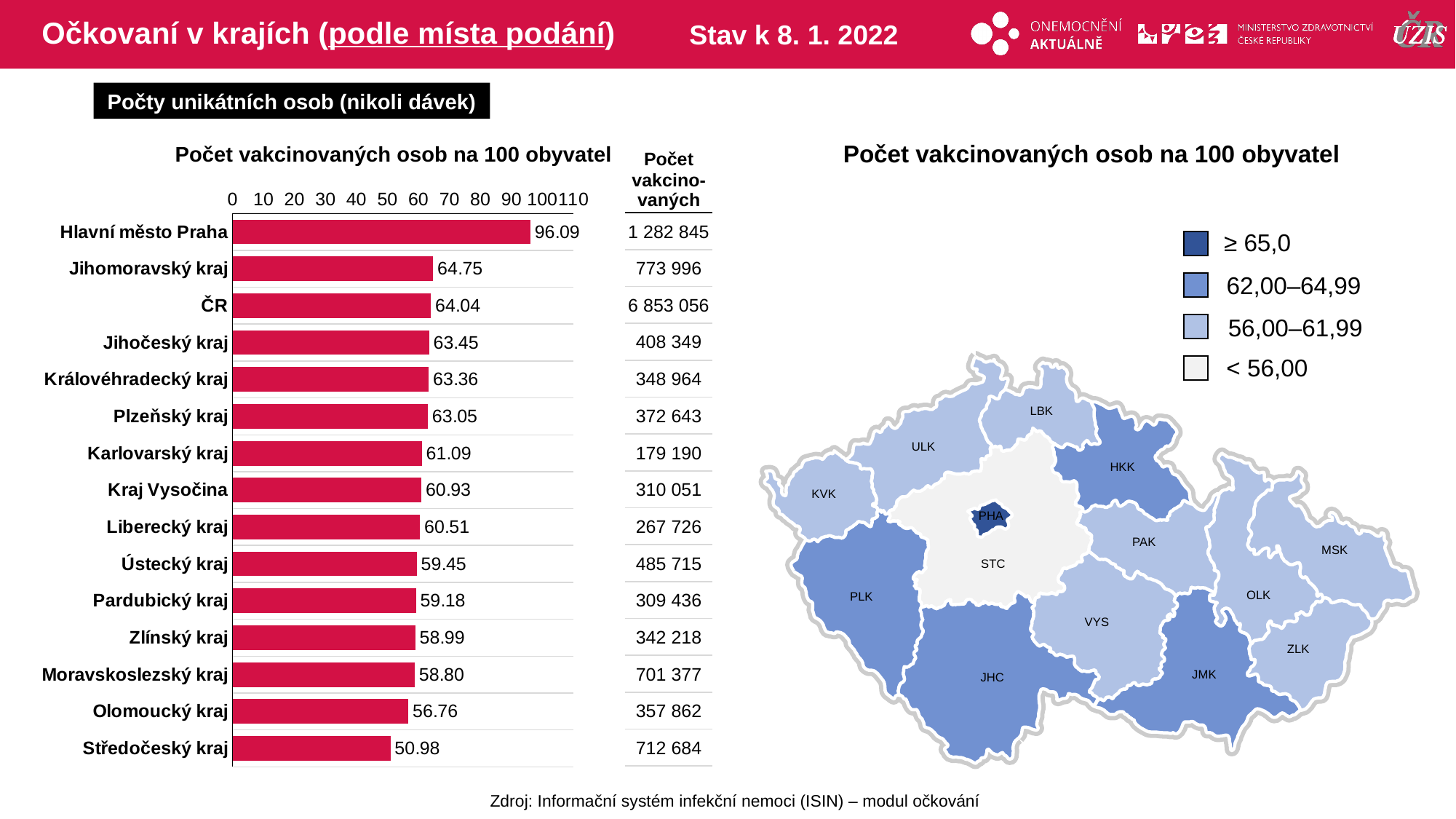
In the bar chart "Počet vakcinovaných osob na 100 obyvatel", what is the value for ČR? 64.04 On the map "Počet vakcinovaných osob na 100 obyvatel", how many categories does the legend list? 4 In the bar chart "Počet vakcinovaných osob na 100 obyvatel", which is larger: the value for Karlovarský kraj or Olomoucký kraj? Karlovarský kraj In the bar chart "Počet vakcinovaných osob na 100 obyvatel", what is the value for Plzeňský kraj? 63.05 What kind of chart is used on the left side of the slide to show "Počet vakcinovaných osob na 100 obyvatel"? bar chart In the table column "Počet vakcinovaných" next to the bar chart, what is the value for Jihočeský kraj? 408 349 In the bar chart "Počet vakcinovaných osob na 100 obyvatel", is the value for Jihomoravský kraj greater or less than 60? greater In the bar chart "Počet vakcinovaných osob na 100 obyvatel", which region has the lowest value? Středočeský kraj In the bar chart "Počet vakcinovaných osob na 100 obyvatel", what is the value for Hlavní město Praha? 96.09 In the bar chart "Počet vakcinovaných osob na 100 obyvatel", which region has the highest value? Hlavní město Praha How many bars (categories) are shown in the bar chart "Počet vakcinovaných osob na 100 obyvatel"? 15 In the bar chart "Počet vakcinovaných osob na 100 obyvatel", what is the difference between the values for Hlavní město Praha and Středočeský kraj? 45.11